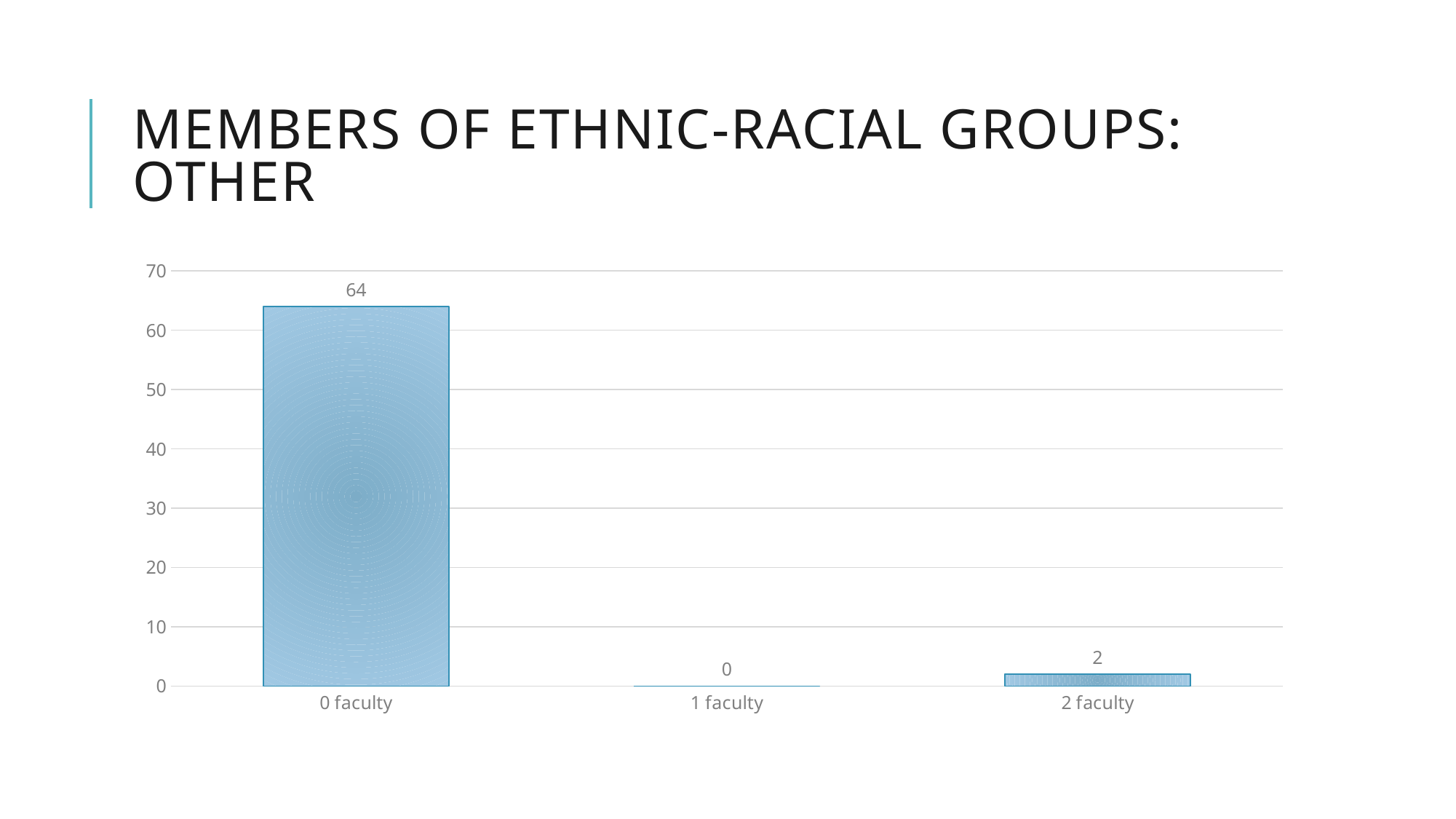
What is the difference between the values for 0 faculty and 2 faculty? 62 Is the value for 0 faculty greater or less than 60? greater How many categories are shown on the x axis? 3 Which is larger, the value for 2 faculty or the value for 1 faculty? 2 faculty What is the value for 2 faculty? 2 Which category has the lowest value? 1 faculty What is the total of the values across all three categories? 66 Which category has the highest value? 0 faculty What is the title of the slide? Members of Ethnic-Racial Groups: Other What is the value for 1 faculty? 0 What kind of chart is shown on the slide? bar chart What is the value for 0 faculty? 64